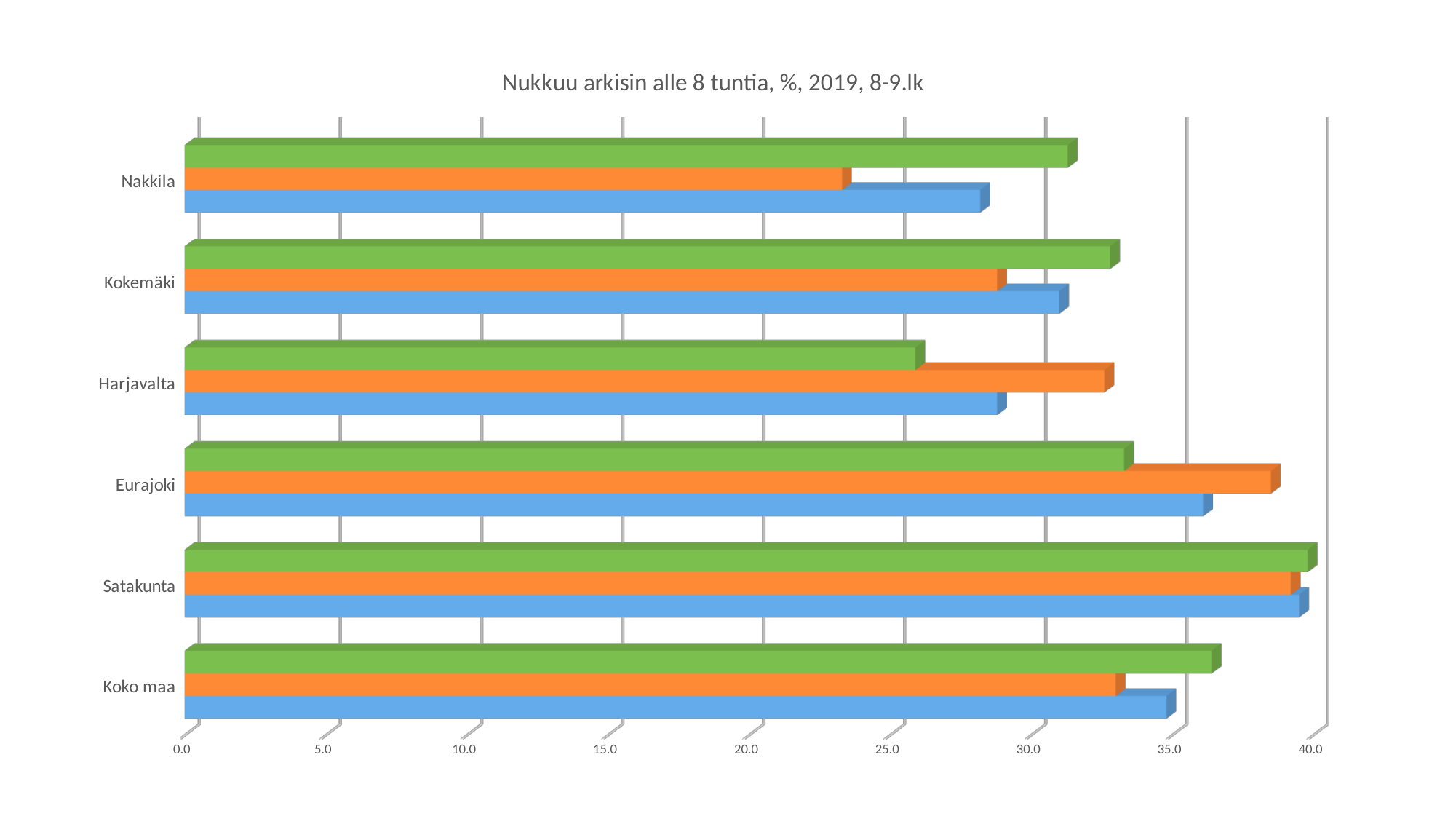
What is the title of the chart? Nukkuu arkisin alle 8 tuntia, %, 2019, 8-9.lk Is the value of the green bar for Nakkila greater or less than 30.0? greater How many bars are plotted for each category in the chart? 3 Which category has the longest green bar? Satakunta For Harjavalta, which bar is longer, the green bar or the orange bar? orange Is the value of the orange bar for Eurajoki greater or less than 35.0? greater Is the value of the orange bar for Nakkila greater or less than 25.0? less Which category has the shortest orange bar? Nakkila How many categories are shown on the vertical axis of the chart? 6 What kind of chart is shown on the slide? bar chart